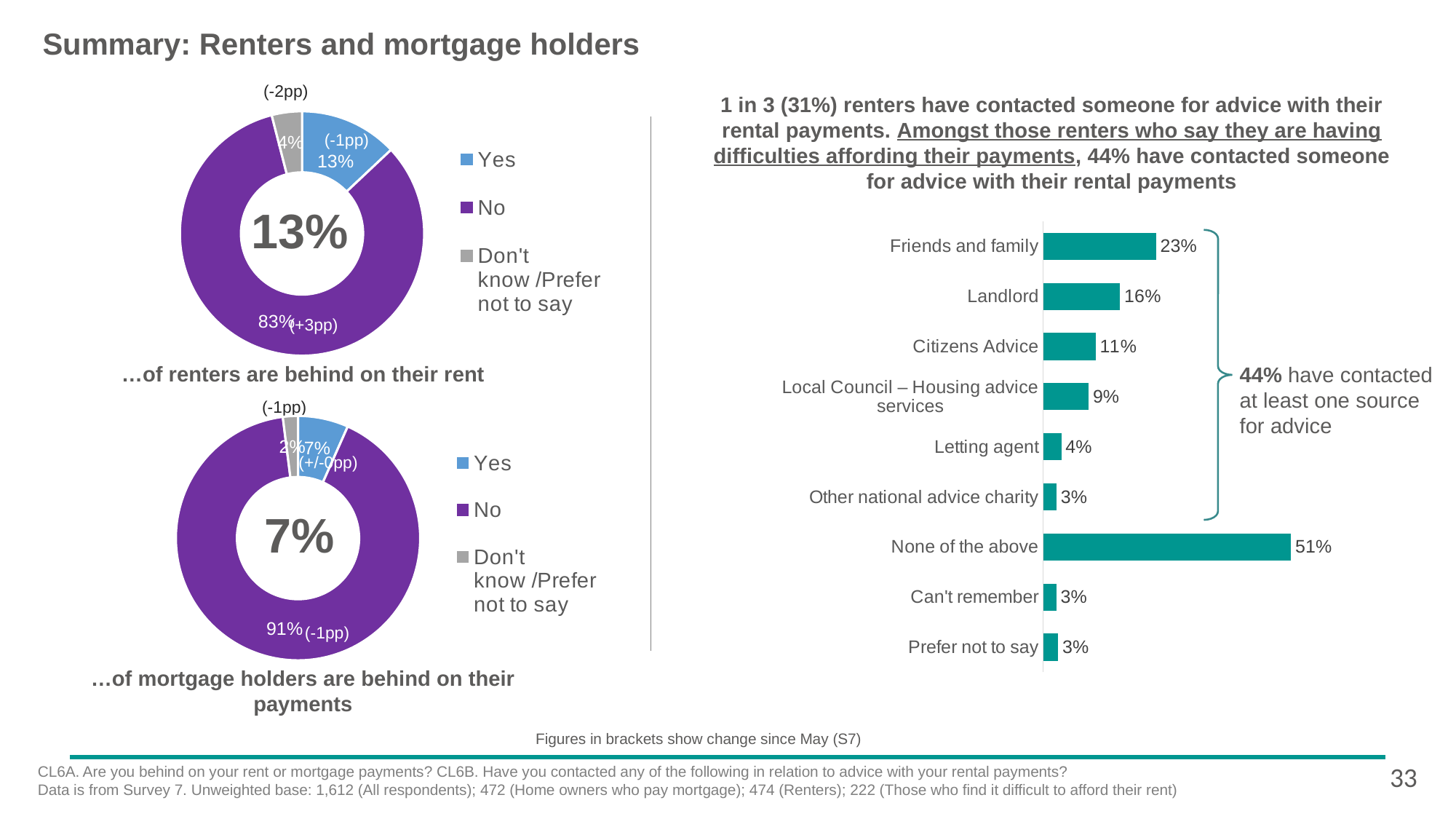
In the donut chart '…of mortgage holders are behind on their payments', what percentage answered Yes? 7% In the bar chart on the right, which is larger: the value for Landlord or the value for Local Council – Housing advice services? Landlord How many entries does the legend of the donut chart '…of renters are behind on their rent' list? 3 How many categories are shown in the bar chart on the right? 9 In the donut chart '…of mortgage holders are behind on their payments', what percentage answered Don't know / Prefer not to say? 2% In the bar chart on the right, what percentage of renters contacted their landlord for advice? 16% In the donut chart '…of renters are behind on their rent', what percentage answered No? 83% What type of chart is used on the right side of the slide to show sources of advice? Bar chart In the bar chart on the right, which category has the highest value? None of the above In the bar chart on the right, what is the difference between the values for Friends and family and Citizens Advice? 12 percentage points In the donut chart '…of renters are behind on their rent', what percentage answered Yes? 13% In the bar chart on the right, what percentage of renters contacted friends and family for advice? 23%